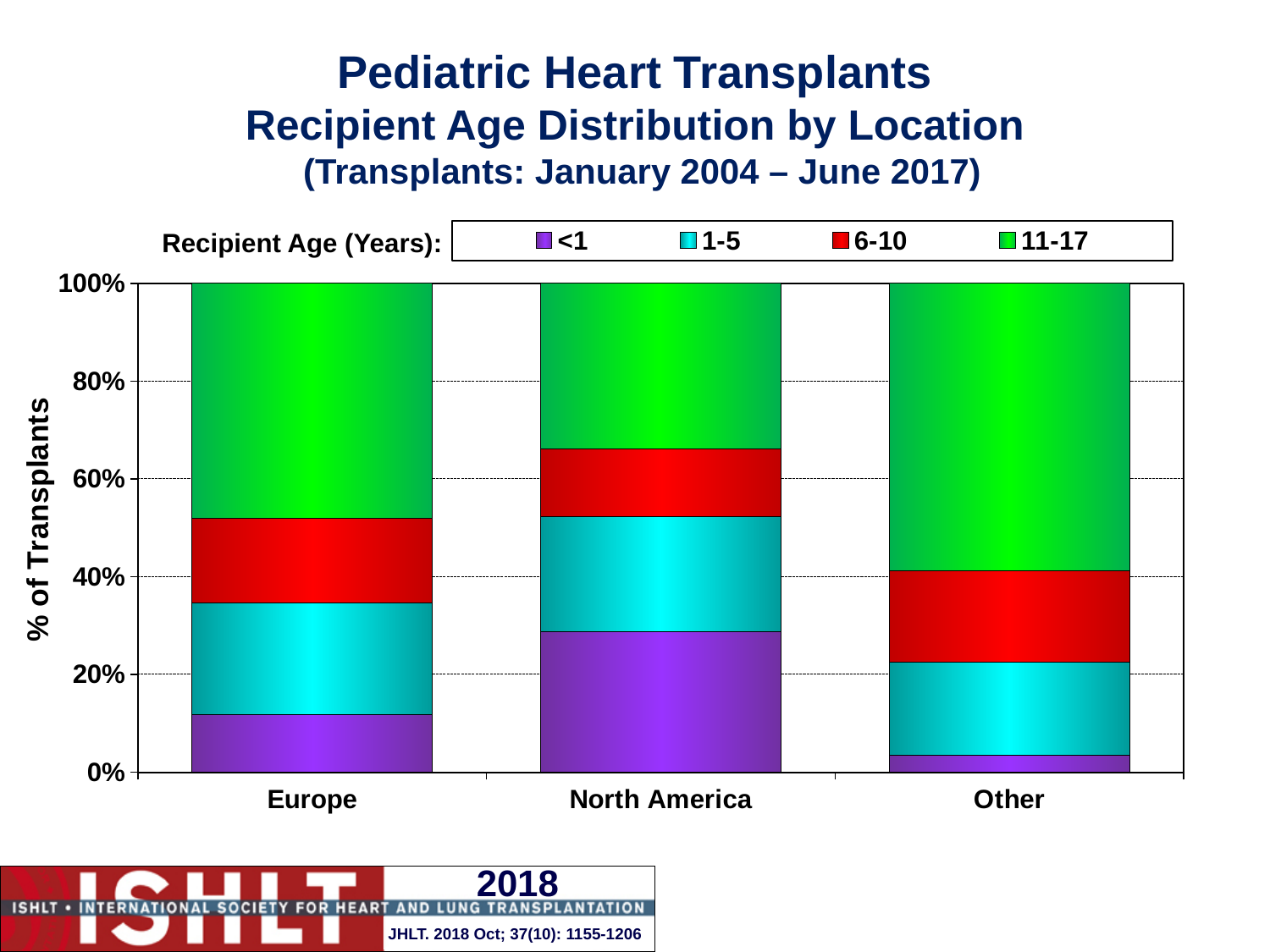
Which location has the largest share of recipients aged 11-17 years? Other Which location has the smallest share of recipients aged <1 year? Other Is the share of recipients aged <1 year in Europe greater or less than 20%? less How many recipient age groups does the legend list? 4 Is the share of recipients aged 11-17 years in North America greater or less than 40%? less What is the title of the legend? Recipient Age (Years): Which has a larger share of recipients aged <1 year, Europe or North America? North America Which location has the largest share of recipients aged <1 year? North America What kind of chart is shown on the slide? Stacked bar chart What is the label of the y axis? % of Transplants How many locations are shown on the x axis of the chart? 3 Is the share of recipients aged <1 year in North America greater or less than 20%? greater